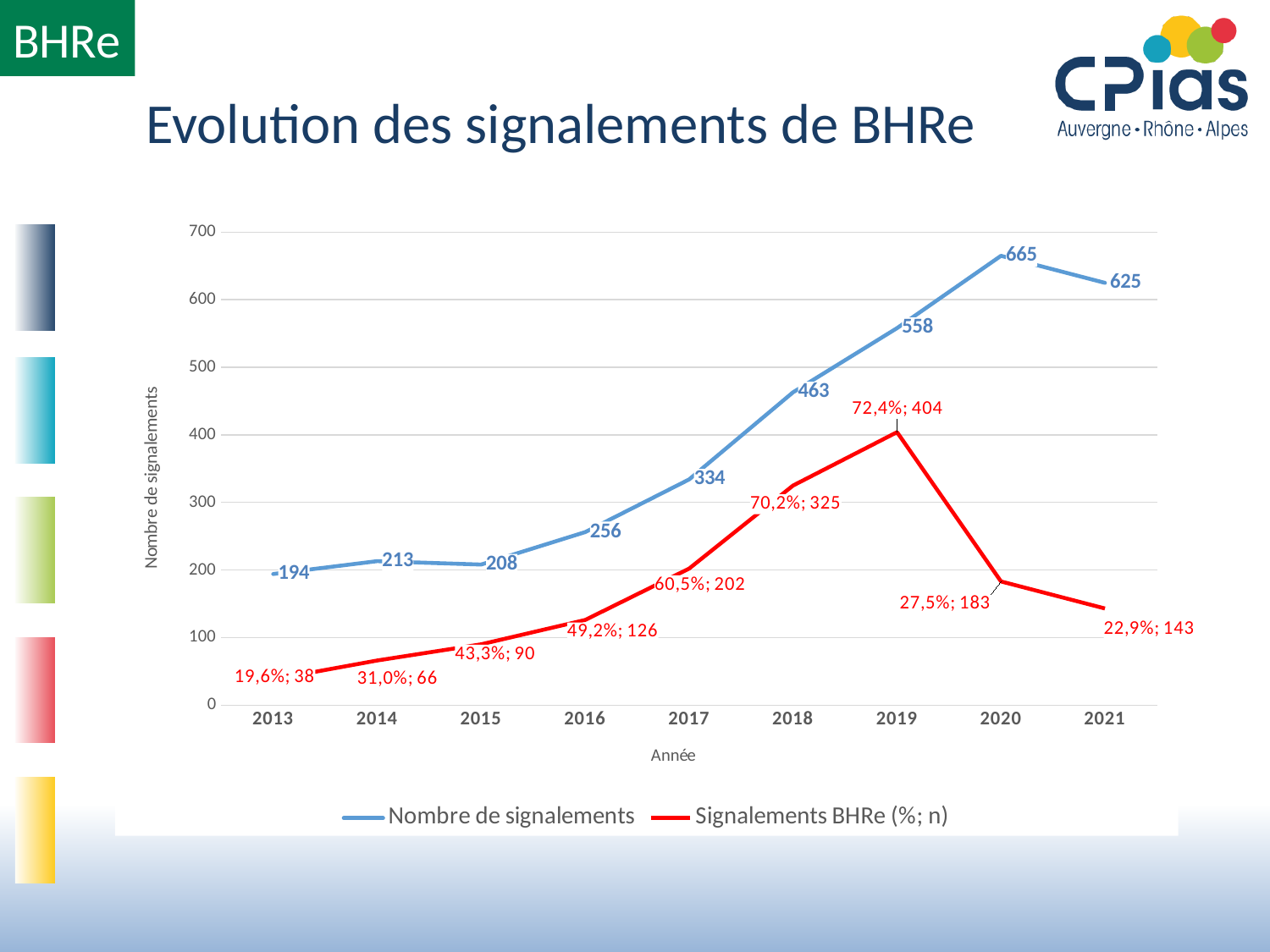
What is the data label for Signalements BHRe in 2021? 22,9%; 143 How many series does the legend list? 2 What kind of chart is shown on the slide? Line chart What is the value of Nombre de signalements in 2020? 665 What is the difference between Nombre de signalements in 2020 and in 2021? 40 What is the data label for Signalements BHRe in 2019? 72,4%; 404 Which is larger: the number of Signalements BHRe in 2018 or in 2020? 2018 What is the value of Nombre de signalements in 2013? 194 In which year is the number of Signalements BHRe lowest? 2013 How many years are shown on the x axis? 9 What is the title of the chart? Evolution des signalements de BHRe In which year is Nombre de signalements highest? 2020